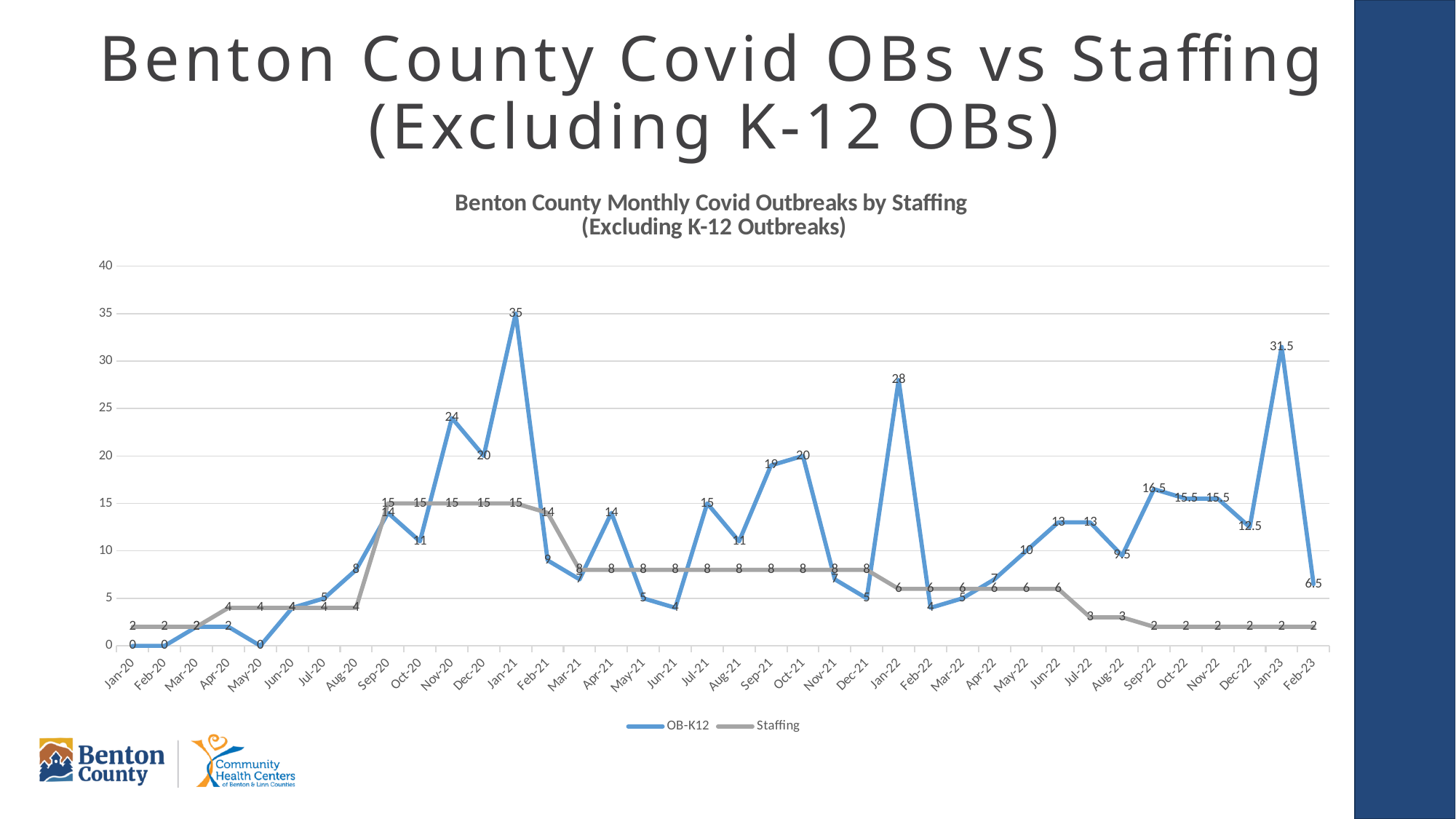
What is the OB-K12 value for Jan-21? 35 What is the OB-K12 value for Feb-23? 6.5 What is the title of the chart? Benton County Monthly Covid Outbreaks by Staffing (Excluding K-12 Outbreaks) What is the difference between the OB-K12 values for Jan-21 and Jan-23? 3.5 What type of chart is shown on the slide? line chart Which month has the higher OB-K12 value, Nov-20 or Dec-20? Nov-20 How many series does the legend list? 2 How many monthly data points are plotted along the x axis? 38 What is the Staffing value for Sep-20? 15 In Jan-22, how much higher is the OB-K12 value than the Staffing value? 22 In which month does the OB-K12 series reach its highest value? Jan-21 What is the OB-K12 value for Jan-22? 28